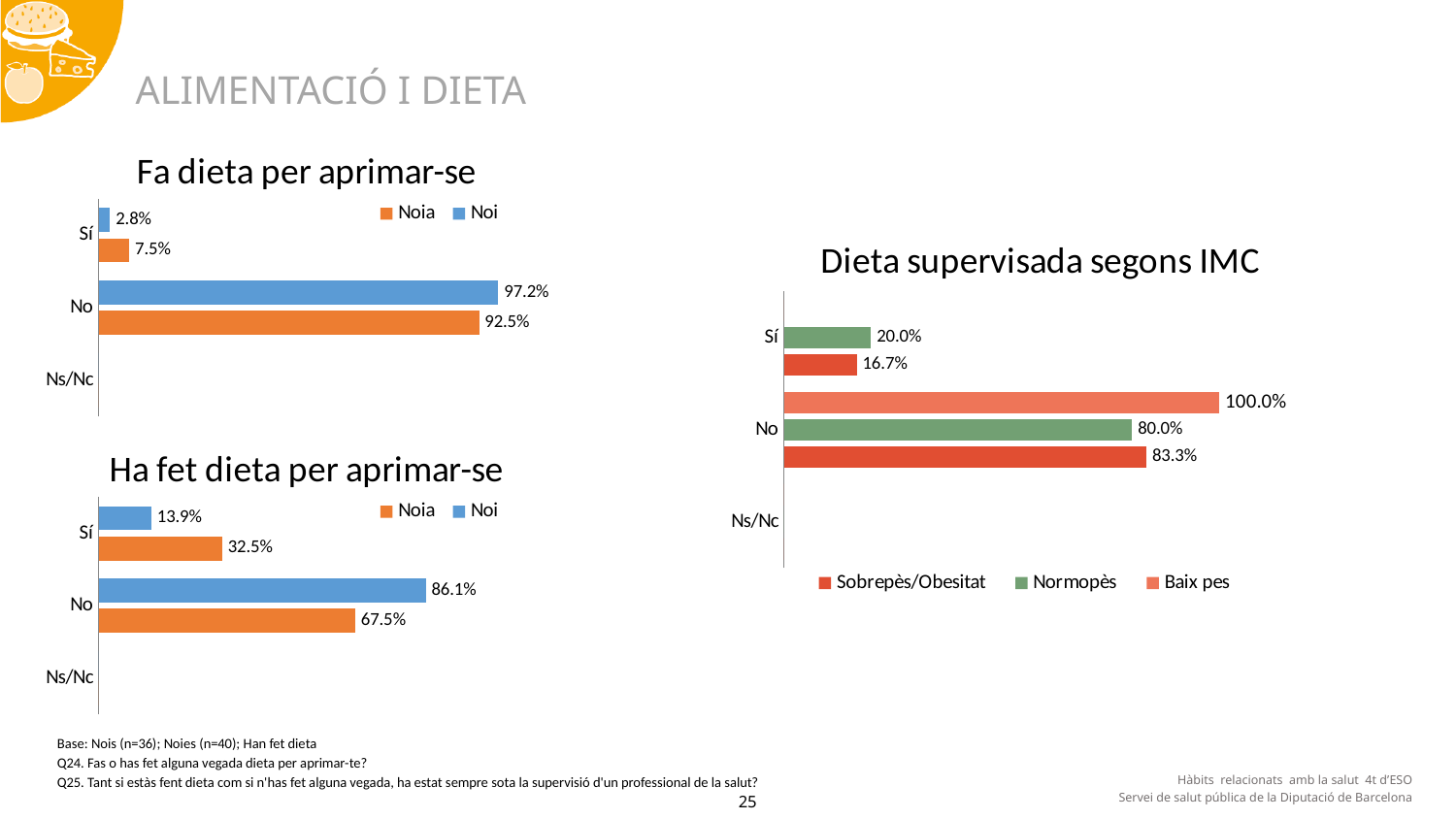
How many series does the legend of the 'Dieta supervisada segons IMC' chart list? 3 In the 'Dieta supervisada segons IMC' chart, what is the value for Sobrepès/Obesitat in the 'Sí' category? 16.7% How many series does the legend of the 'Ha fet dieta per aprimar-se' chart list? 2 In the 'Fa dieta per aprimar-se' chart, what is the difference between the Noi and Noia values for 'No'? 4.7% In the 'Fa dieta per aprimar-se' chart, what is the value for Noia in the 'Sí' category? 7.5% In the 'Dieta supervisada segons IMC' chart, what is the value for Baix pes in the 'No' category? 100.0% In the 'Ha fet dieta per aprimar-se' chart, what is the value for Noia in the 'Sí' category? 32.5% In the 'Dieta supervisada segons IMC' chart, which series has the highest value in the 'No' category? Baix pes In the 'Fa dieta per aprimar-se' chart, what is the value for Noi in the 'No' category? 97.2% In the 'Ha fet dieta per aprimar-se' chart, which is larger for 'Sí': Noi or Noia? Noia In the 'Ha fet dieta per aprimar-se' chart, what is the difference between the Noi and Noia values for 'No'? 18.6% What type of chart is 'Dieta supervisada segons IMC'? Bar chart